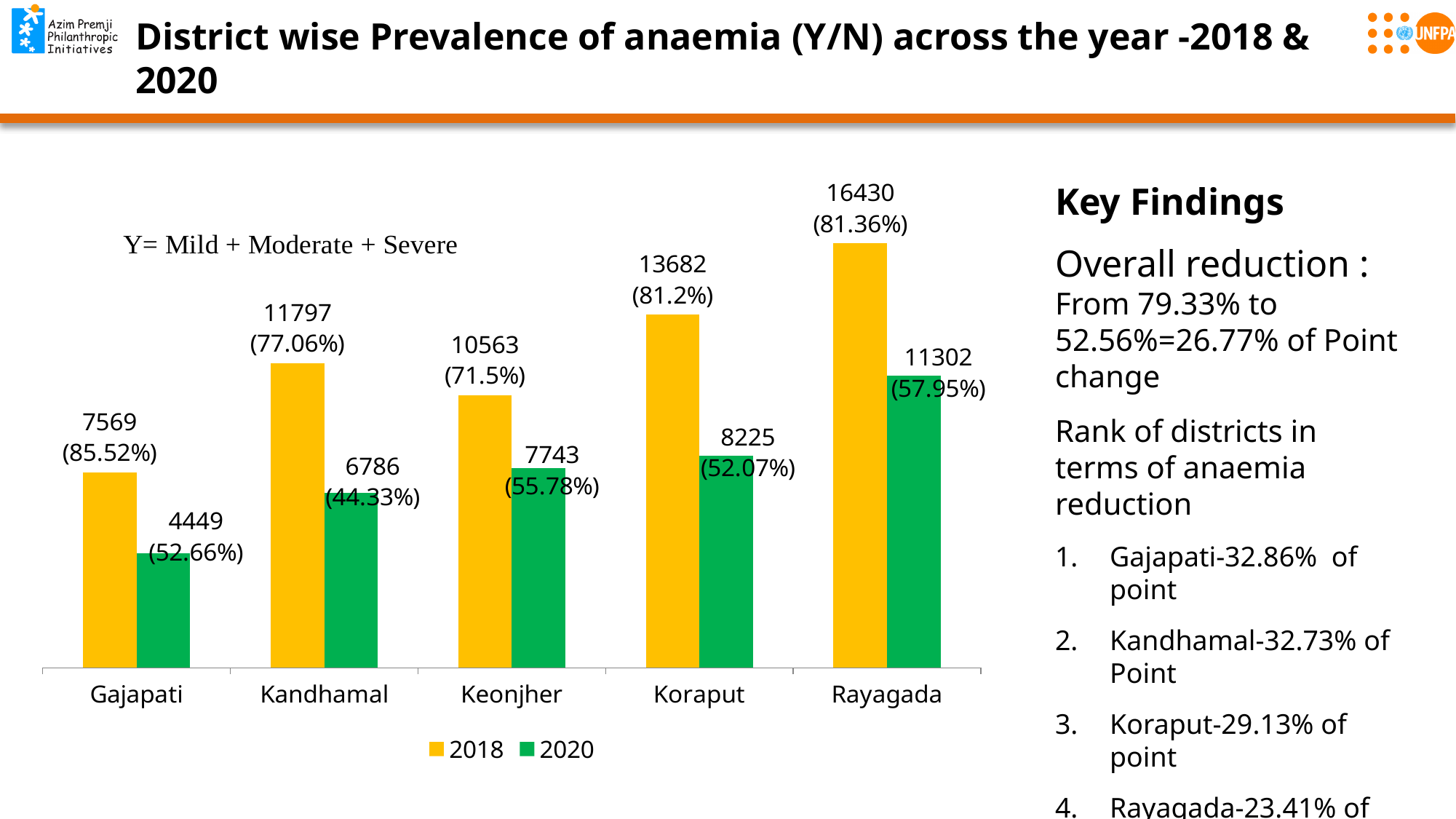
Which colour represents the 2020 series in the chart? Green What kind of chart is shown on the slide? Bar chart What is the difference between the 2018 counts for Kandhamal and Keonjher? 1234 Which is larger, the 2020 value for Keonjher or the 2020 value for Koraput? Koraput What is the 2020 value for Gajapati? 4449 (52.66%) How many series does the legend list? 2 Which district has the highest 2018 value? Rayagada What is the 2018 value for Koraput? 13682 (81.2%) How many districts are shown on the x axis? 5 What is the 2020 value for Kandhamal? 6786 (44.33%) What is the difference between the 2018 and 2020 counts for Rayagada? 5128 Which district has the lowest 2020 value? Gajapati